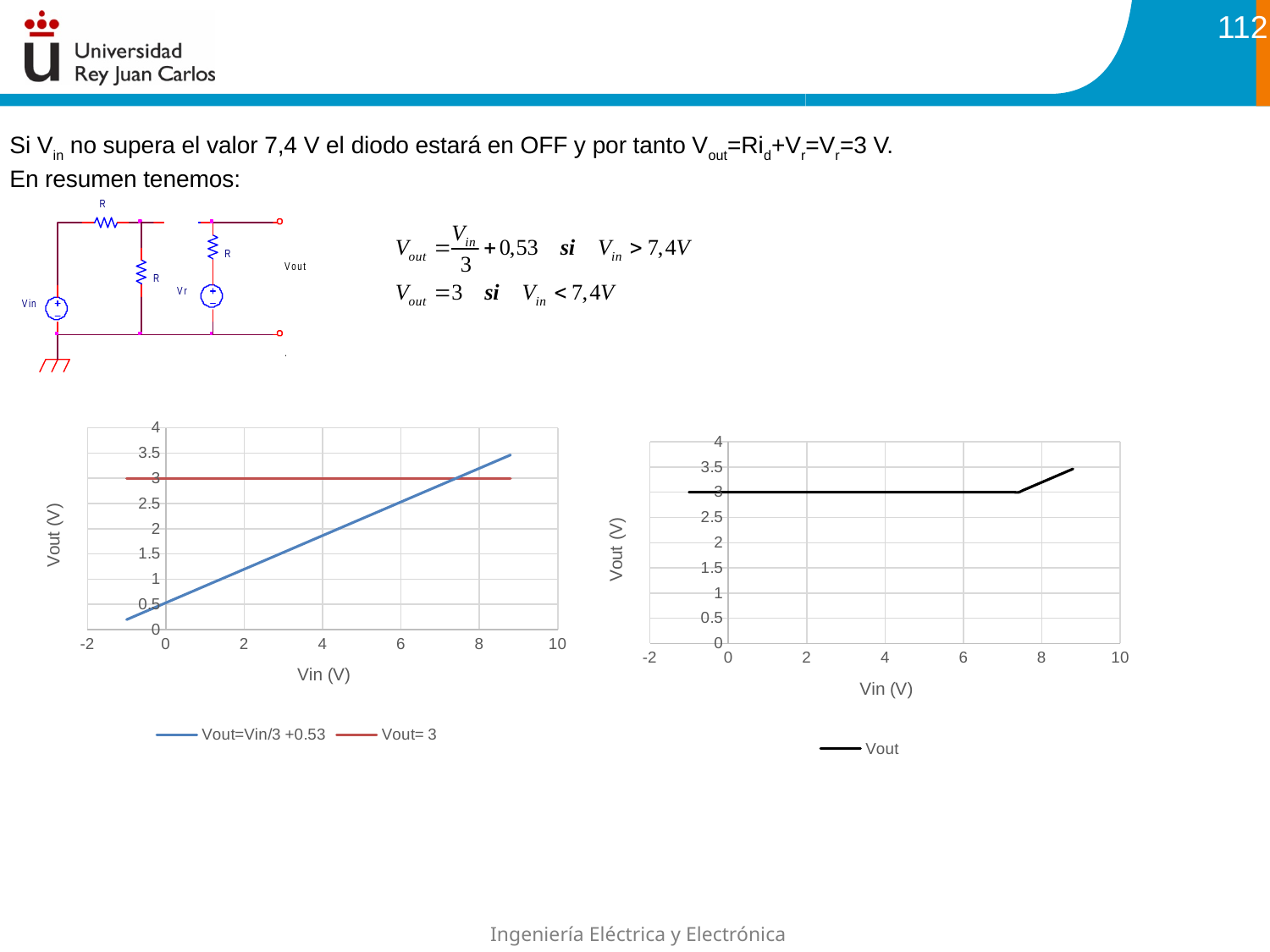
In the right chart, what is the title of the horizontal axis? Vin (V) In the left chart, at Vin = 2, which series has the higher value: Vout=Vin/3 +0.53 or Vout= 3? Vout= 3 How many series does the legend of the right chart list? 1 How many series does the legend of the left chart list? 2 In the left chart, is the value of Vout=Vin/3 +0.53 at Vin = 6 greater or less than 3? less In the left chart, does the series Vout=Vin/3 +0.53 rise or fall as Vin increases? Rises In the left chart, what are the two series named in the legend? Vout=Vin/3 +0.53 and Vout= 3 In the right chart, is the value of Vout at Vin = 4 greater or less than 2? greater In the left chart, is the value of Vout=Vin/3 +0.53 at Vin = 2 greater or less than 1? greater What kind of chart is the left chart on the slide? Line chart In the left chart, does the series Vout= 3 rise, fall or stay flat as Vin increases? Stays flat What kind of chart is the right chart on the slide? Line chart